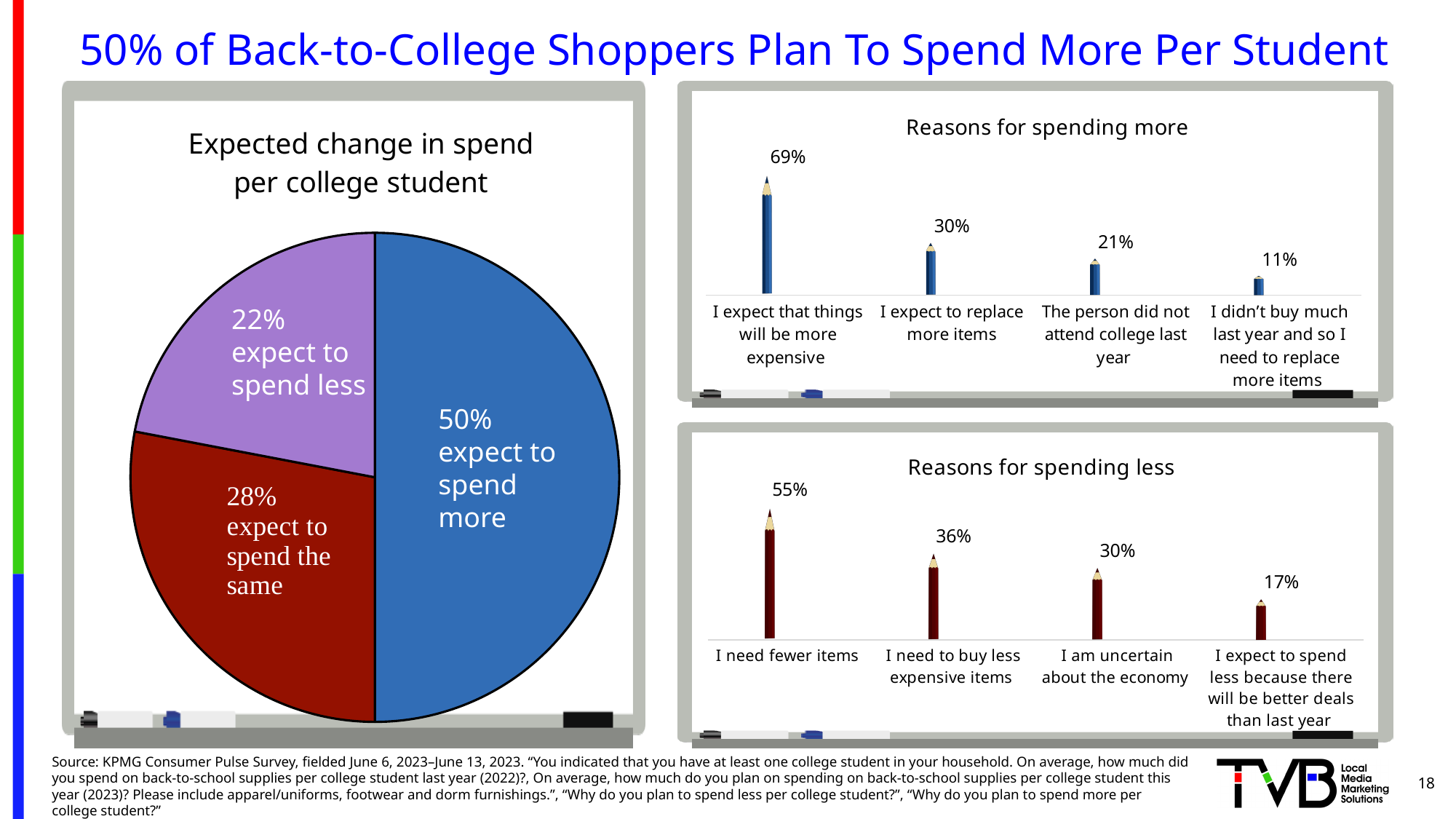
What kind of chart is 'Expected change in spend per college student'? pie chart In the 'Reasons for spending less' chart, which reason has the lowest value? I expect to spend less because there will be better deals than last year In the 'Expected change in spend per college student' chart, what share of shoppers expect to spend the same? 28% In the 'Reasons for spending less' chart, what is the value for 'I am uncertain about the economy'? 30% In the 'Expected change in spend per college student' chart, what share of shoppers expect to spend more? 50% In the 'Reasons for spending more' chart, what is the value for 'I expect to replace more items'? 30% In the 'Reasons for spending more' chart, what is the difference between 'I expect that things will be more expensive' and 'The person did not attend college last year'? 48% In the 'Reasons for spending less' chart, do the values rise or fall from left to right? fall How many reasons are shown in the 'Reasons for spending more' chart? 4 In the 'Reasons for spending more' chart, which reason has the highest value? I expect that things will be more expensive In the 'Expected change in spend per college student' chart, which category has the smallest share? expect to spend less In the 'Reasons for spending less' chart, which is larger: 'I need fewer items' or 'I need to buy less expensive items'? I need fewer items